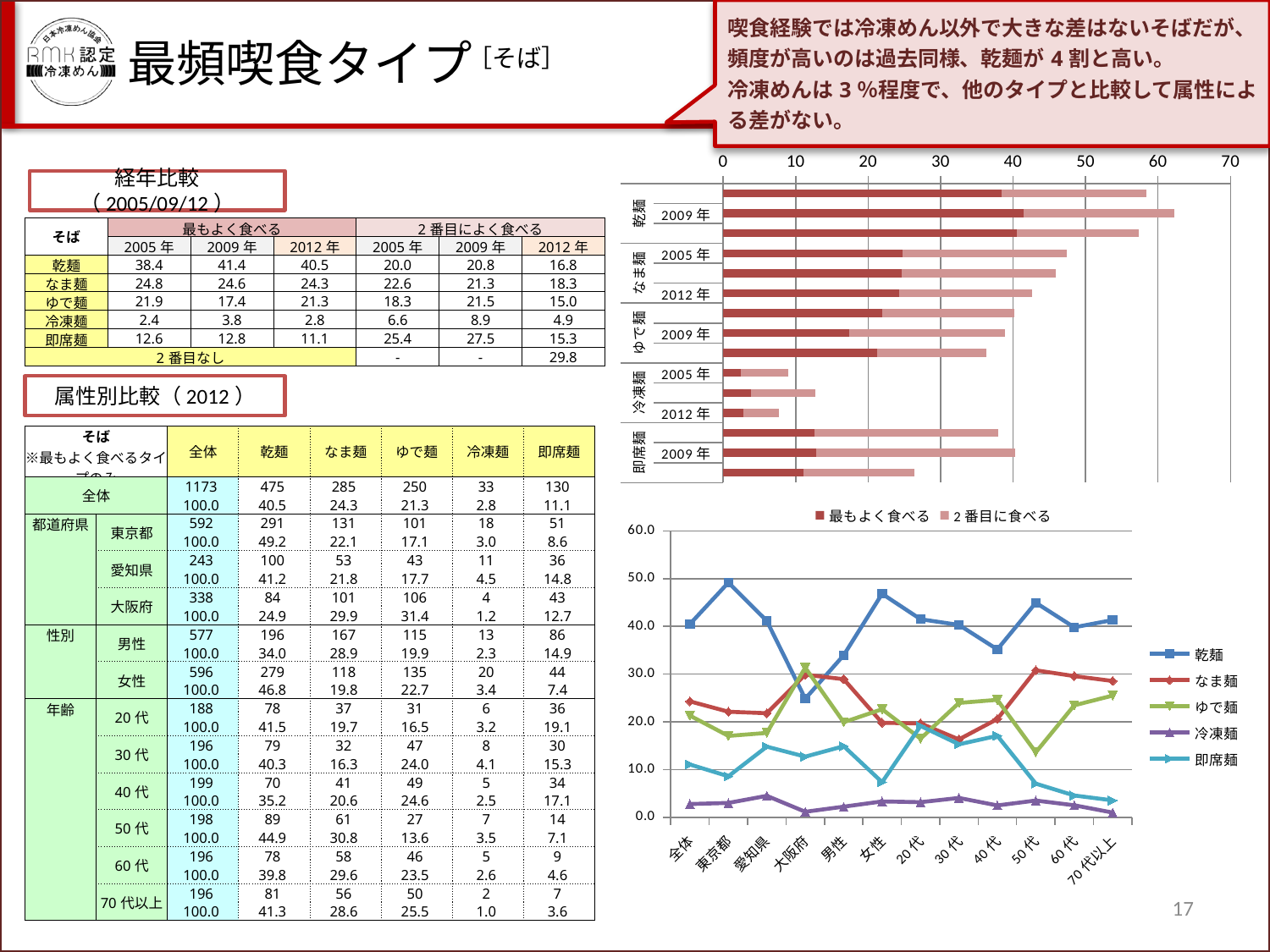
What kind of chart is the chart at the top right of the slide? bar chart In the bottom-right line chart, is the value of 乾麺 for 東京都 greater or less than 40? greater In the top-right bar chart, is the 最もよく食べる segment for 乾麺 2005年 greater or less than 30? greater How many categories are on the x axis of the bottom-right line chart? 12 In the top-right bar chart, how many bars are plotted in total? 15 In the top-right bar chart, is the full stacked bar for 冷凍麺 2012年 greater or less than 10? less How many series does the legend of the bottom-right line chart list? 5 In the top-right bar chart, which category has the shortest bars overall? 冷凍麺 What kind of chart is the chart at the bottom right of the slide? line chart In the bottom-right line chart, which series is the lowest across all categories? 冷凍麺 How many series does the legend of the top-right bar chart list? 2 In the bottom-right line chart, at 大阪府, which is larger: 乾麺 or ゆで麺? ゆで麺